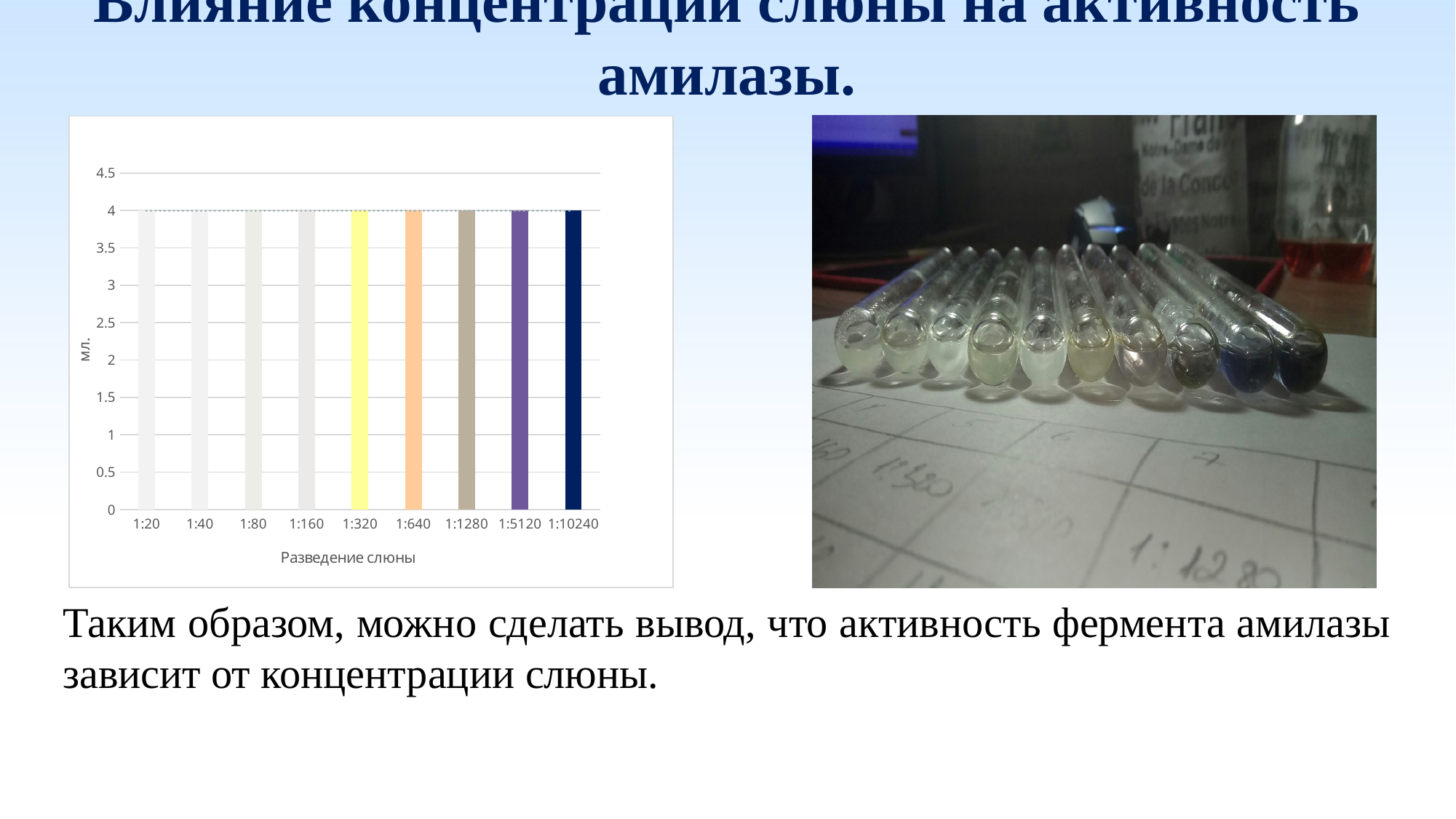
How many categories (dilutions) are shown on the x axis of the chart? 9 What is the value for the 1:10240 dilution in the chart? 4 What kind of chart is shown on the slide? bar chart What is the label of the x axis of the chart? Разведение слюны Is the value for 1:1280 greater or less than 3? greater Is the value for 1:320 greater or less than 4.5? less What is the label of the y axis of the chart? мл. Do the values rise, fall, or stay constant across the dilutions on the x axis? stay constant What is the value for the 1:640 dilution in the chart? 4 What is the value for the 1:20 dilution in the chart? 4 What is the difference between the values for 1:20 and 1:5120? 0